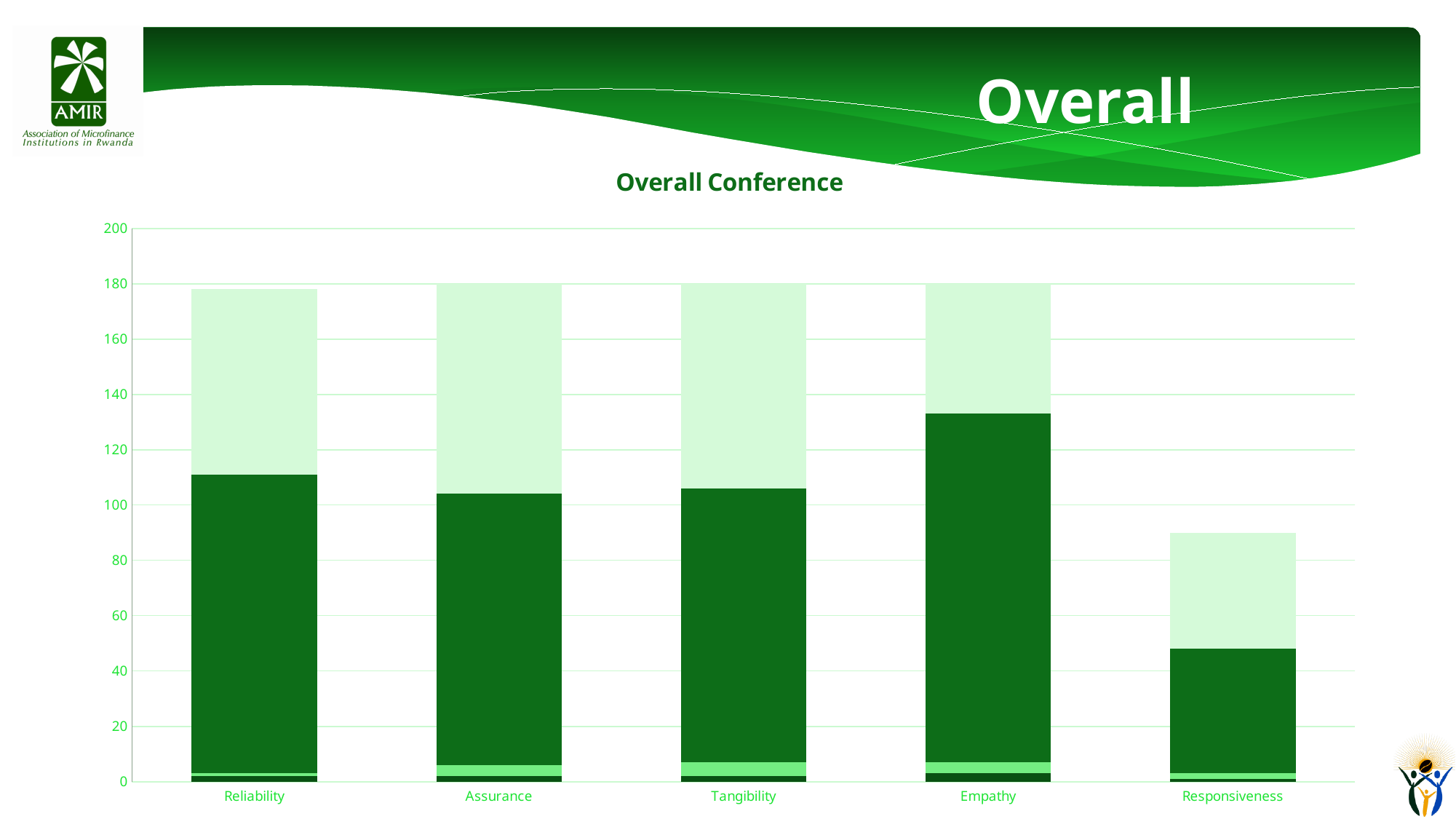
Is the top of the dark green segment for Responsiveness greater or less than 60? less What is the title of the chart? Overall Conference How many categories are shown on the x axis of the chart? 5 What type of chart is shown on the slide? Stacked bar chart Which category has the tallest dark green segment? Empathy Which category has the lowest total stacked bar height? Responsiveness Which has the larger total stacked bar, Empathy or Responsiveness? Empathy Is the top of the dark green segment for Empathy greater or less than 120? greater Is the total stacked bar for Responsiveness greater or less than 100? less What is the highest value shown on the vertical axis? 200